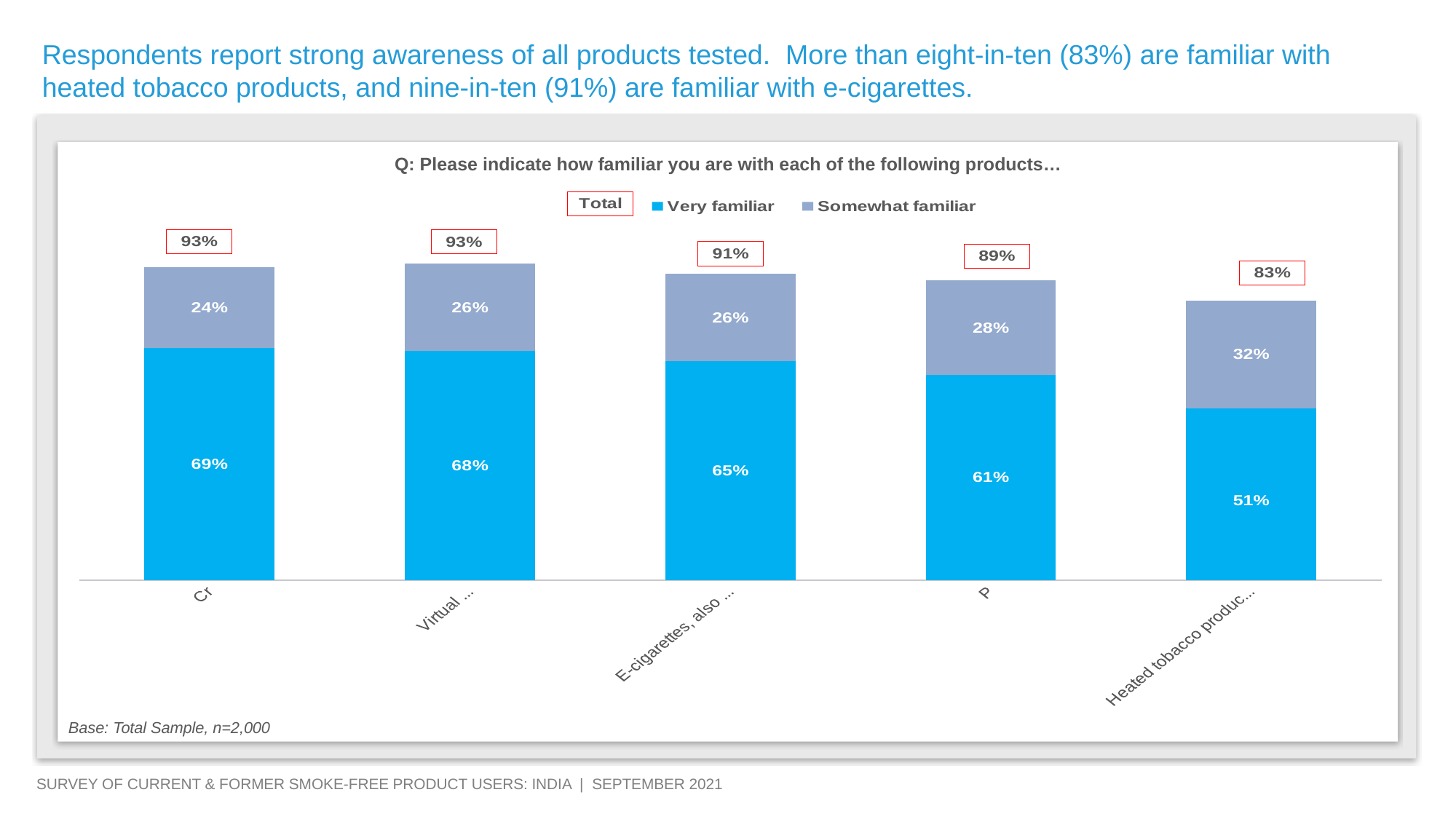
Which product has the lowest 'Very familiar' share? Heated tobacco products What kind of chart is shown on the slide? Stacked bar chart What percentage of respondents are 'Somewhat familiar' with heated tobacco products? 32% What is the 'Very familiar' value shown on the fourth bar from the left? 61% What is the total familiarity shown above the heated tobacco products bar? 83% What is the total familiarity shown above the e-cigarettes bar? 91% Which has the larger 'Somewhat familiar' share: e-cigarettes or heated tobacco products? Heated tobacco products How many series does the chart legend list? 2 Which product has the lowest total familiarity? Heated tobacco products What percentage of respondents are 'Very familiar' with e-cigarettes? 65% How many product categories are plotted in the chart? 5 How many percentage points higher is the 'Very familiar' share for e-cigarettes than for heated tobacco products? 14 percentage points